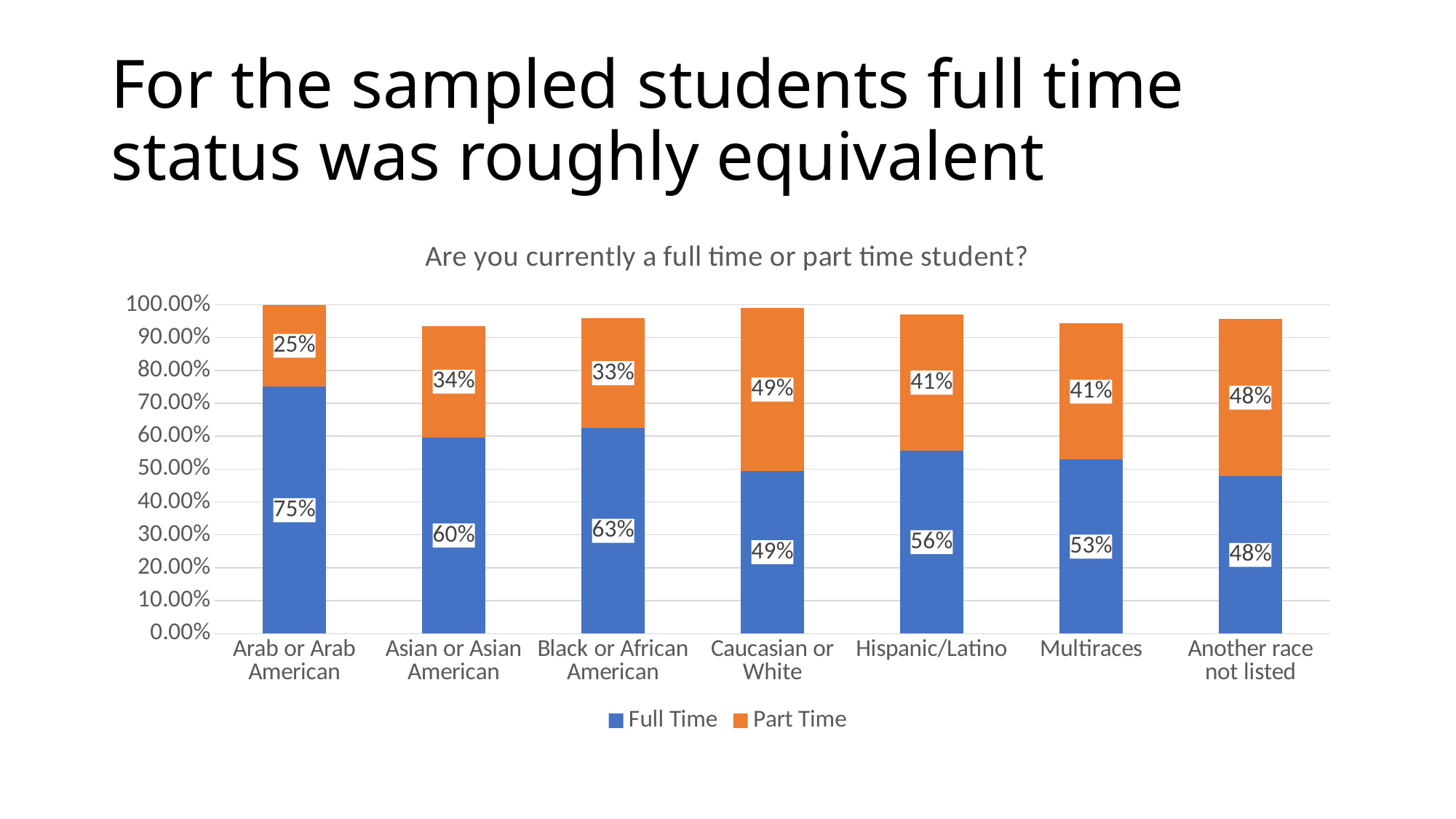
How many series does the legend list? 2 What is the Full Time value for Hispanic/Latino? 56% What is the Full Time value for Arab or Arab American? 75% What is the title of the chart? Are you currently a full time or part time student? What is the Part Time value for Asian or Asian American? 34% Which is larger, the Full Time value for Asian or Asian American or the Full Time value for Black or African American? Black or African American What kind of chart is shown on the slide? Stacked bar chart Which category has the lowest Part Time value? Arab or Arab American Which category has the highest Full Time value? Arab or Arab American What is the Part Time value for Caucasian or White? 49% How many categories are shown on the x axis? 7 What is the difference between the Full Time values for Black or African American and Multiraces? 10%